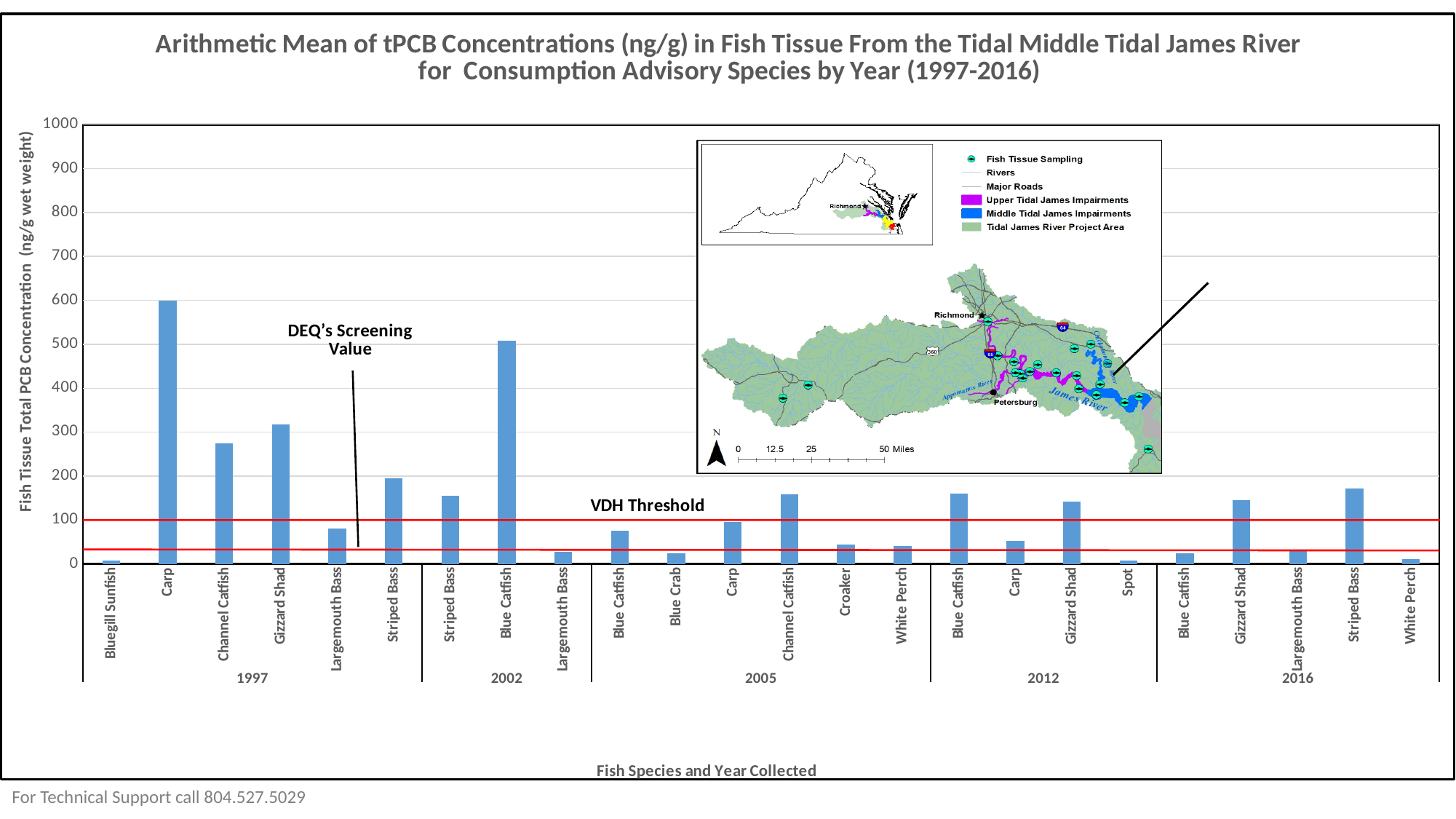
How many bars are plotted for the year 2016? 5 Is the value for Channel Catfish in 2005 greater or less than 100? greater Is the value for Blue Catfish in 2002 greater or less than 400? greater Which is larger, the value for Carp in 2005 or the value for Carp in 2012? Carp in 2005 Which species and year has the highest tPCB concentration on the chart? Carp, 1997 Is the value for Carp in 1997 greater or less than 500? greater What is the label of the upper red horizontal line on the chart? VDH Threshold What kind of chart is shown on the slide? bar chart Which is larger, the value for Carp in 1997 or the value for Blue Catfish in 2002? Carp in 1997 How many year groups are shown along the x axis? 5